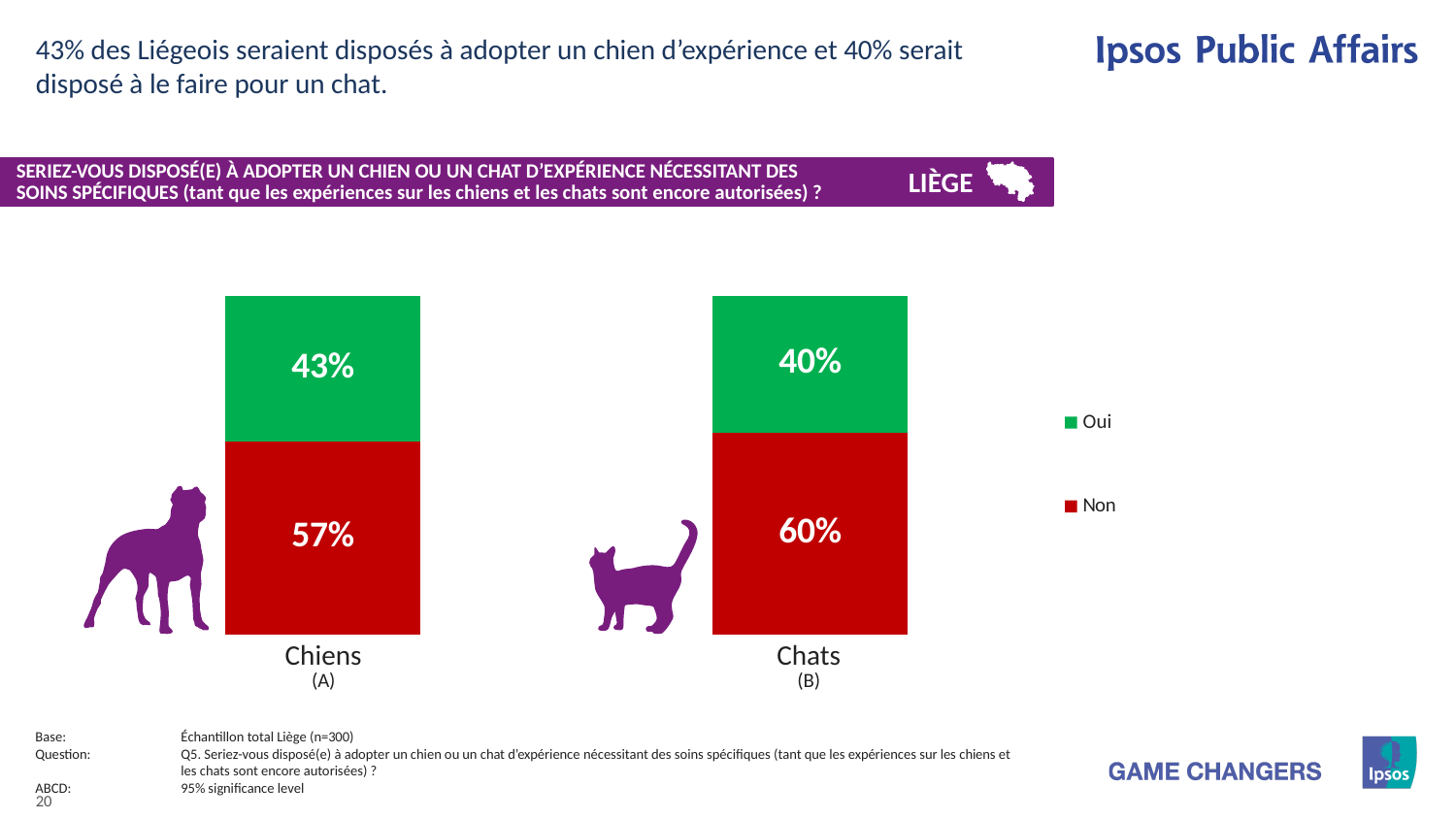
What percentage of respondents answered "Oui" for Chiens? 43% Which colour represents "Non" in the legend? Red What kind of chart is shown on the slide? Stacked bar chart What percentage of respondents answered "Non" for Chiens? 57% What is the total of the stacked bar for Chiens? 100% What percentage of respondents answered "Non" for Chats? 60% Which category has the higher "Oui" share, Chiens or Chats? Chiens Which category has the highest "Non" value? Chats What percentage of respondents answered "Oui" for Chats? 40% How many categories are shown on the x axis? 2 What is the difference between the "Non" values for Chats and Chiens? 3% How many series does the legend list? 2